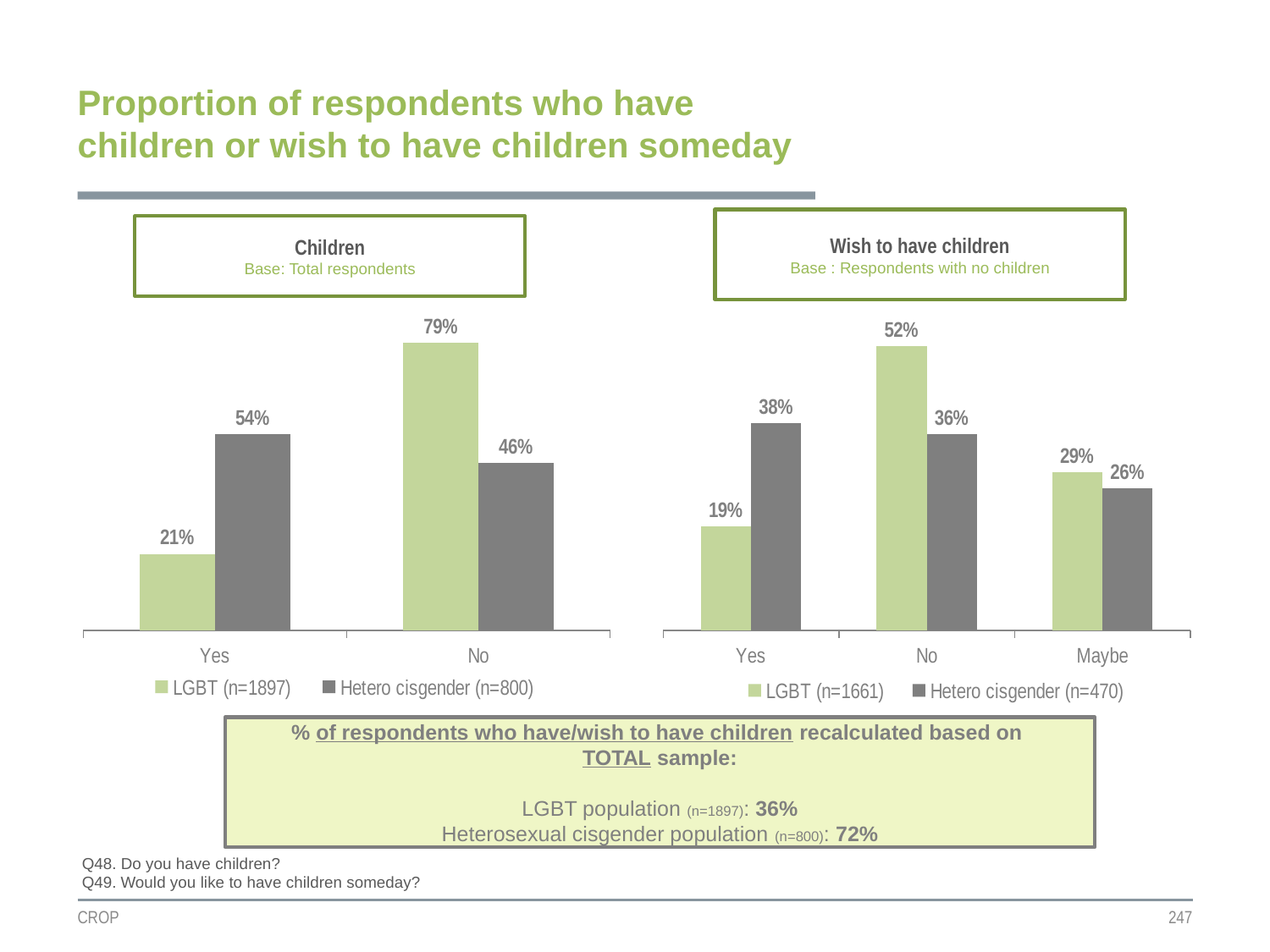
In the "Children" chart, what is the difference between the LGBT and Hetero cisgender values for No? 33 percentage points What type of chart is the "Children" chart? Bar chart How many response categories are shown on the x axis of the "Wish to have children" chart? 3 In the "Wish to have children" chart, what is the difference between the LGBT and Hetero cisgender values for No? 16 percentage points In the "Wish to have children" chart, which response has the highest LGBT value? No In the "Wish to have children" chart, what percentage of LGBT respondents answered Maybe? 29% In the "Wish to have children" chart, what percentage of Hetero cisgender respondents answered Yes? 38% How many series does the legend of the "Children" chart list? 2 In the "Children" chart, what percentage of LGBT respondents answered Yes? 21% In the "Wish to have children" chart, which response has the lowest Hetero cisgender value? Maybe In the "Children" chart, which is larger for Yes: the LGBT value or the Hetero cisgender value? Hetero cisgender In the "Children" chart, what percentage of Hetero cisgender respondents answered No? 46%